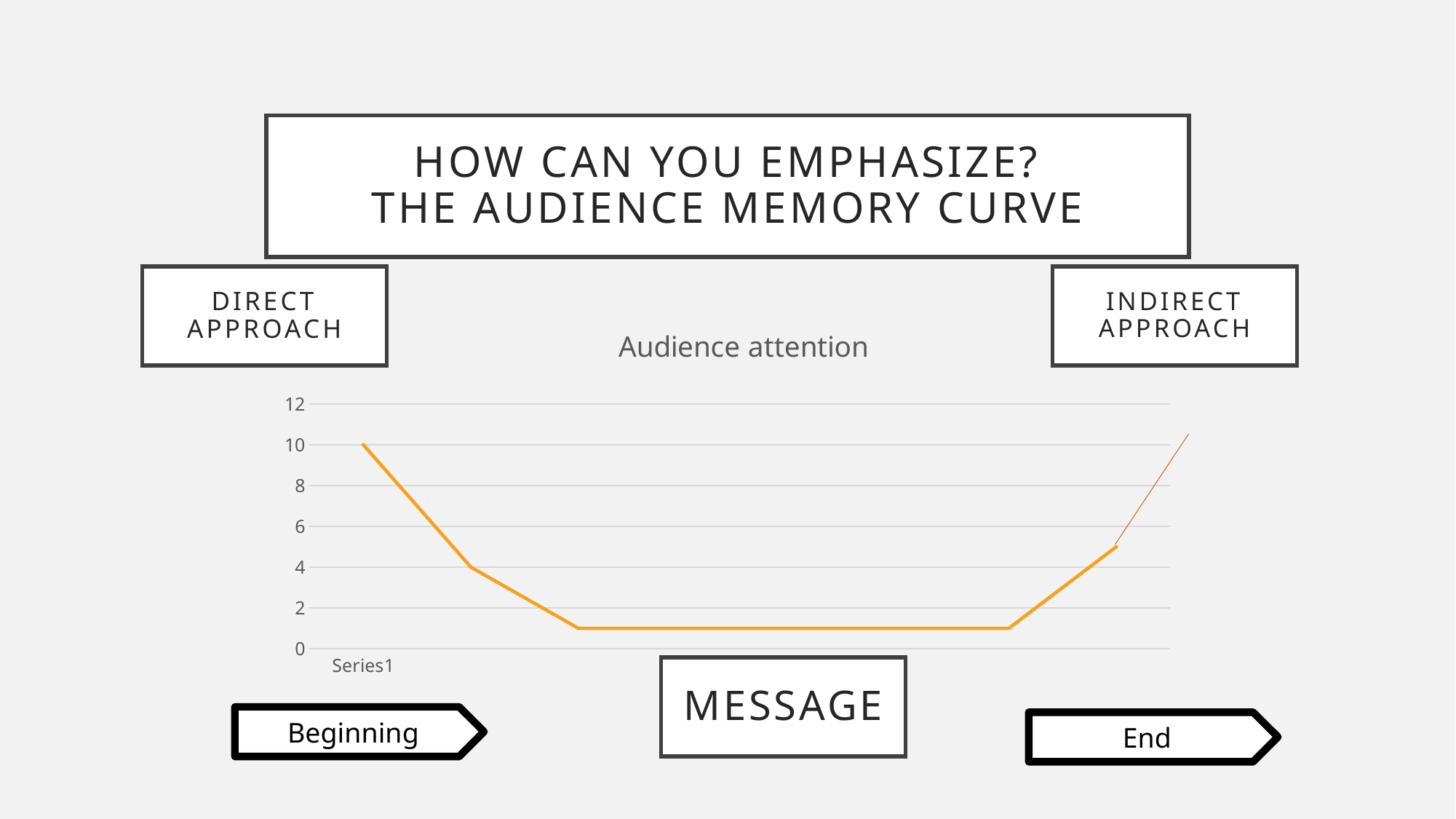
What is the title of the chart? Audience attention What value does the line start at on the left of the chart? 10 Is the value in the flat middle section of the line greater or less than 2? less Is the starting value of the line greater or less than 8? greater What label appears under the x axis of the chart? Series1 What kind of chart is shown on the slide? line chart Does the line rise or fall from the beginning toward the middle of the chart? fall Does the line rise or fall from the middle toward the end of the chart? rise Is the value at the start of the orange line higher or lower than the value at its right end? higher Is the value at the right end of the orange line greater or less than 4? greater